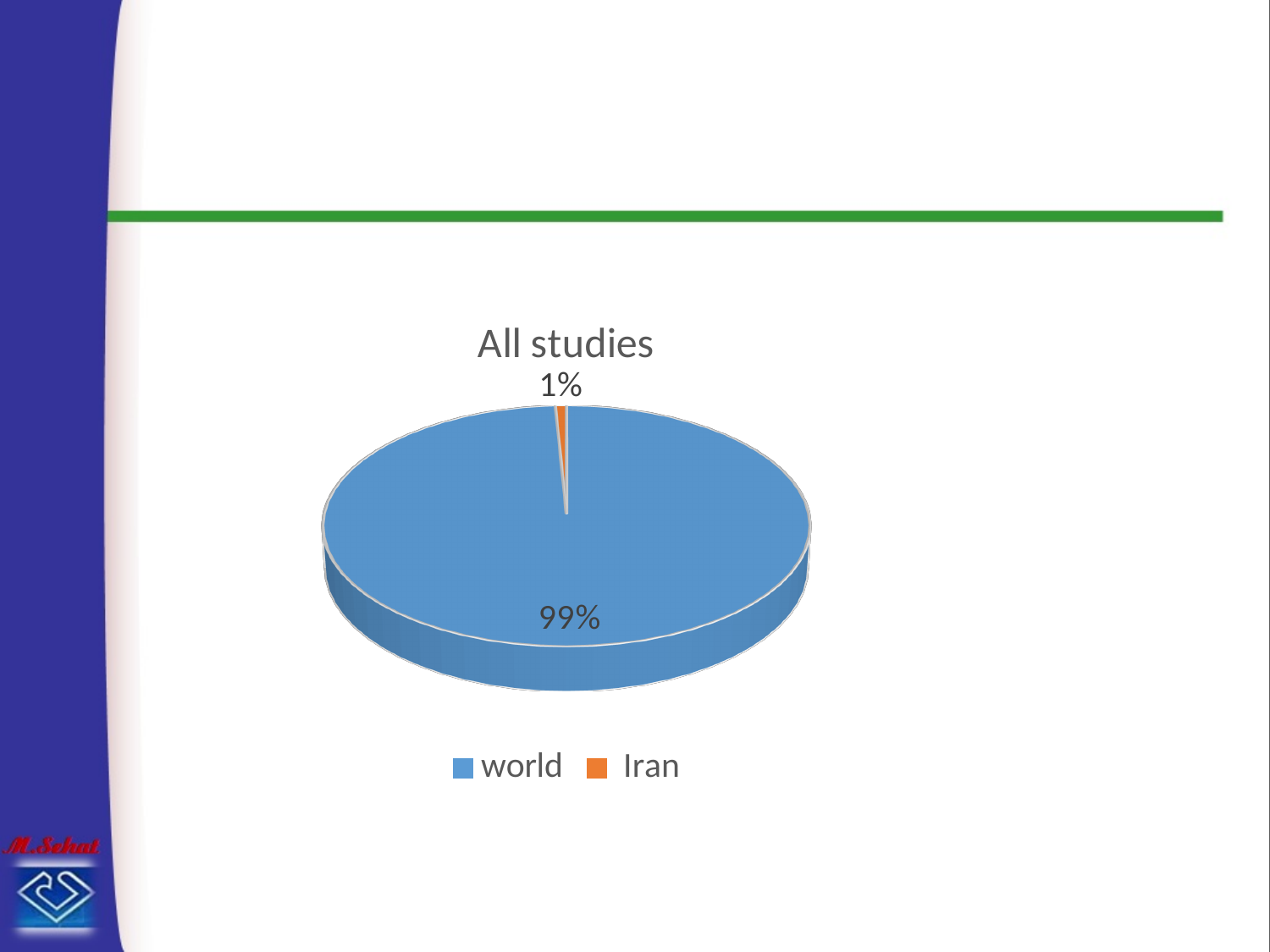
Which category has the smallest slice of the pie? Iran What share of the pie does world account for? 99% Which category has the largest slice of the pie? world What is the title of the chart? All studies What share of the pie does Iran account for? 1% What kind of chart is shown on the slide? pie chart What is the difference in percentage points between the world slice and the Iran slice? 98 Which is larger, the slice for world or the slice for Iran? world How many entries does the legend list? 2 How many categories does the pie chart show? 2 What colour is the slice for Iran? orange